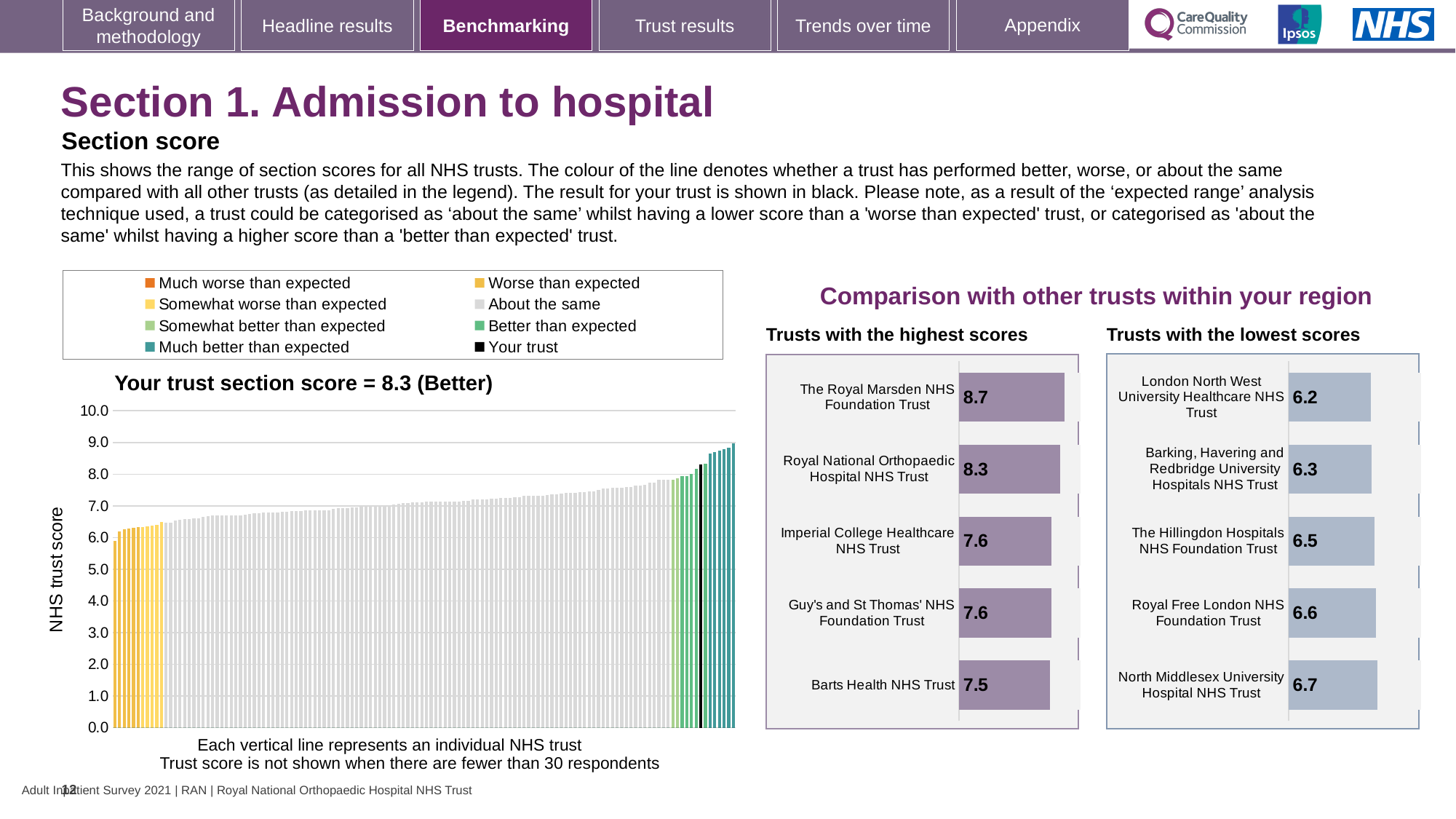
What is the section score for your trust shown in the title of the left-hand chart? 8.3 How many entries does the legend above the left-hand chart list? 8 What type of chart is the 'Trusts with the lowest scores' chart? bar chart In the 'Trusts with the lowest scores' chart, which has the larger score: Royal Free London NHS Foundation Trust or Barking, Havering and Redbridge University Hospitals NHS Trust? Royal Free London NHS Foundation Trust In the 'Trusts with the highest scores' chart, what is the difference between the scores of The Royal Marsden NHS Foundation Trust and Barts Health NHS Trust? 1.2 In the 'Trusts with the lowest scores' chart, what is the difference between the scores of North Middlesex University Hospital NHS Trust and London North West University Healthcare NHS Trust? 0.5 In the 'Trusts with the lowest scores' chart, what is the score for The Hillingdon Hospitals NHS Foundation Trust? 6.5 In the 'Trusts with the highest scores' chart, what is the score for The Royal Marsden NHS Foundation Trust? 8.7 In the 'Trusts with the highest scores' chart, which trust has the highest score? The Royal Marsden NHS Foundation Trust In the left-hand chart of all NHS trusts, do the bars rise or fall from left to right? rise In the 'Trusts with the lowest scores' chart, which trust has the lowest score? London North West University Healthcare NHS Trust How many trusts are shown in the 'Trusts with the highest scores' chart? 5